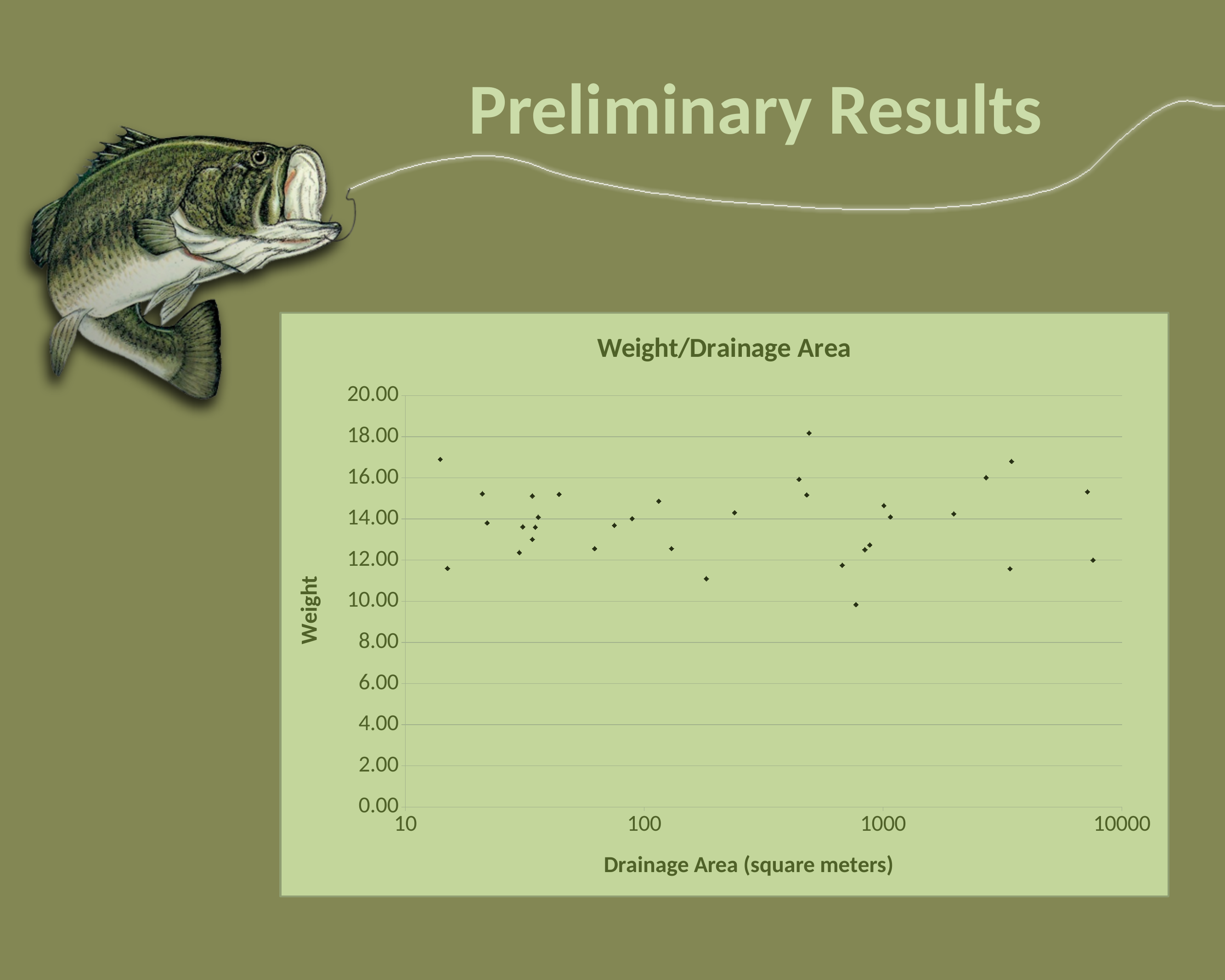
Are all the weights plotted on the chart greater or less than 8.00? greater Is the highest weight plotted on the chart greater or less than 20.00? less What is the smallest tick value shown on the Drainage Area axis? 10 What is the largest tick value shown on the Drainage Area axis? 10000 What is the label of the horizontal axis of the chart? Drainage Area (square meters) What is the highest tick value shown on the Weight axis? 20.00 Is the highest weight plotted on the chart greater or less than 18.00? greater What kind of chart is shown on the slide? scatter plot What is the title of the chart? Weight/Drainage Area